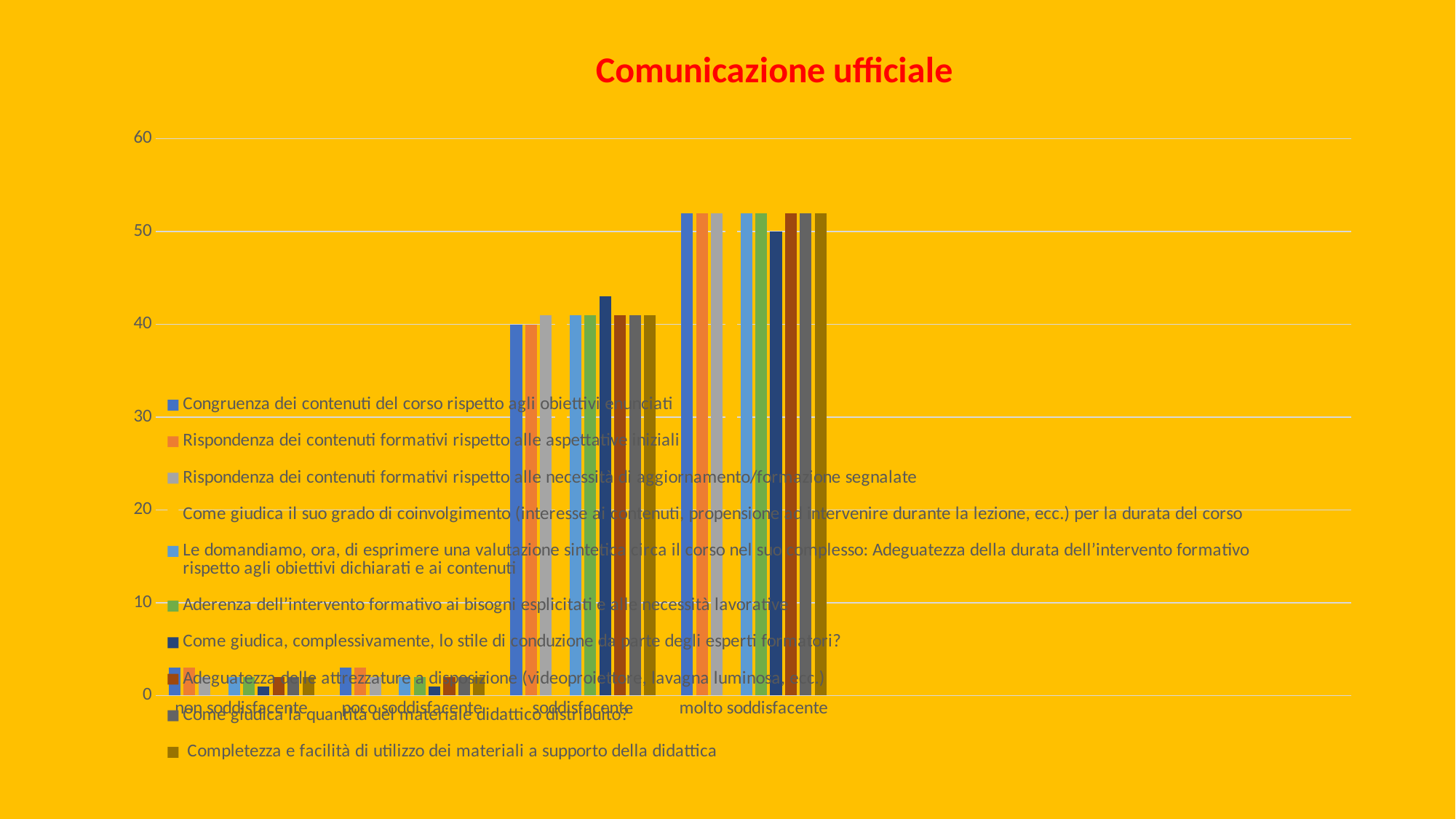
For the series 'Congruenza dei contenuti del corso rispetto agli obiettivi enunciati', which is larger: 'soddisfacente' or 'molto soddisfacente'? molto soddisfacente Is the value for 'soddisfacente' in the series 'Congruenza dei contenuti del corso rispetto agli obiettivi enunciati' greater or less than 50? less Is the value for 'non soddisfacente' in the series 'Congruenza dei contenuti del corso rispetto agli obiettivi enunciati' greater or less than 10? less How many series does the chart's legend list? 10 Is the value for 'molto soddisfacente' in the series 'Congruenza dei contenuti del corso rispetto agli obiettivi enunciati' greater or less than 40? greater What colour is the chart title text? red Do the values generally rise or fall moving from 'non soddisfacente' to 'molto soddisfacente' along the x axis? rise Which category has the highest values across the series? molto soddisfacente How many categories are shown on the x axis of the chart? 4 What kind of chart is shown on the slide? bar chart What is the title of the chart? Comunicazione ufficiale